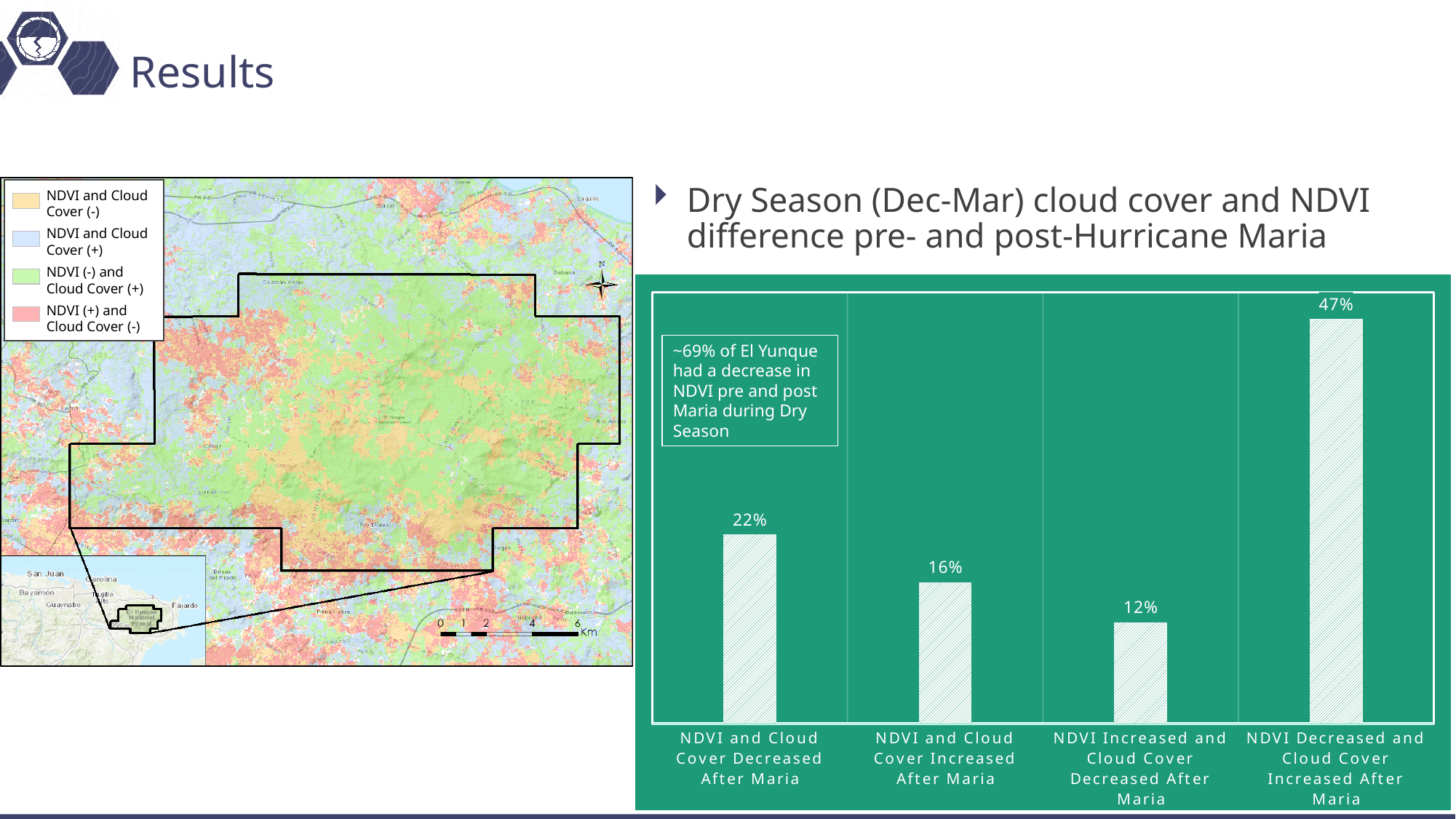
What is the value for "NDVI Decreased and Cloud Cover Increased After Maria"? 47% Which category has the highest value in the bar chart? NDVI Decreased and Cloud Cover Increased After Maria What kind of chart is shown on the right side of the slide? Bar chart What is the difference between the values for "NDVI Decreased and Cloud Cover Increased After Maria" and "NDVI and Cloud Cover Decreased After Maria"? 25% According to the text box inside the chart, approximately what percentage of El Yunque had a decrease in NDVI pre and post Maria during Dry Season? ~69% What is the value for "NDVI Increased and Cloud Cover Decreased After Maria"? 12% Which is larger: the value for "NDVI and Cloud Cover Increased After Maria" or "NDVI Increased and Cloud Cover Decreased After Maria"? NDVI and Cloud Cover Increased After Maria What is the difference between the values for "NDVI and Cloud Cover Decreased After Maria" and "NDVI and Cloud Cover Increased After Maria"? 6% What is the value for "NDVI and Cloud Cover Decreased After Maria"? 22% Which category has the lowest value in the bar chart? NDVI Increased and Cloud Cover Decreased After Maria What is the value for "NDVI and Cloud Cover Increased After Maria"? 16% How many categories are shown in the bar chart? 4